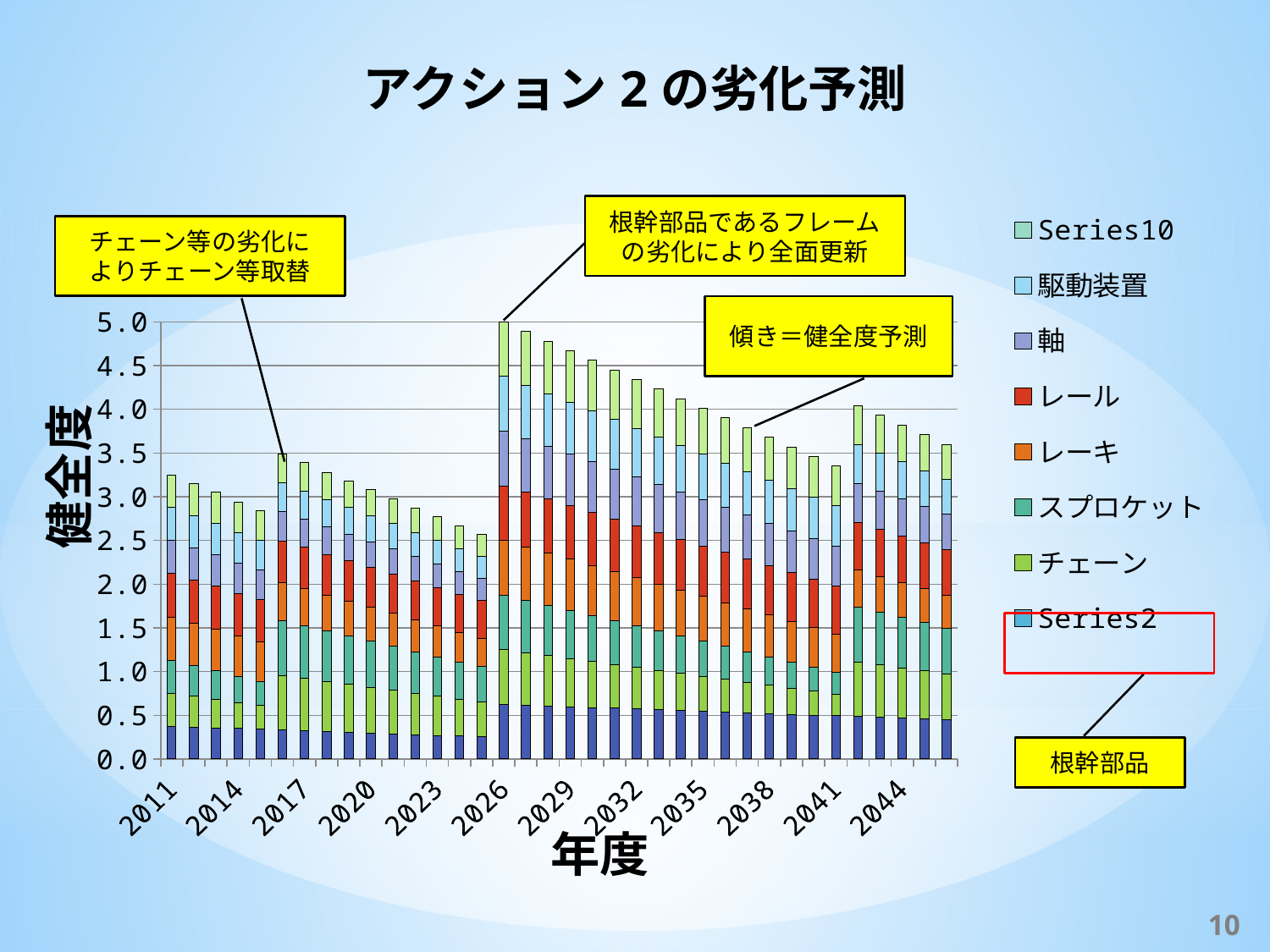
Is the total value for 2027 greater or less than 4.5? greater Do the total bar heights rise or fall from 2026 to 2041? fall Is the total value for 2040 greater or less than 4.0? less Which year has the larger total bar, 2015 or 2016? 2016 Is the total value for 2025 greater or less than 3.0? less What is the title of the chart? アクション２の劣化予測 Which year has the larger total bar, 2011 or 2026? 2026 What is the label of the vertical axis? 健全度 Which year has the tallest stacked bar? 2026 How many series does the legend list? 8 What kind of chart is shown on the slide? stacked bar chart